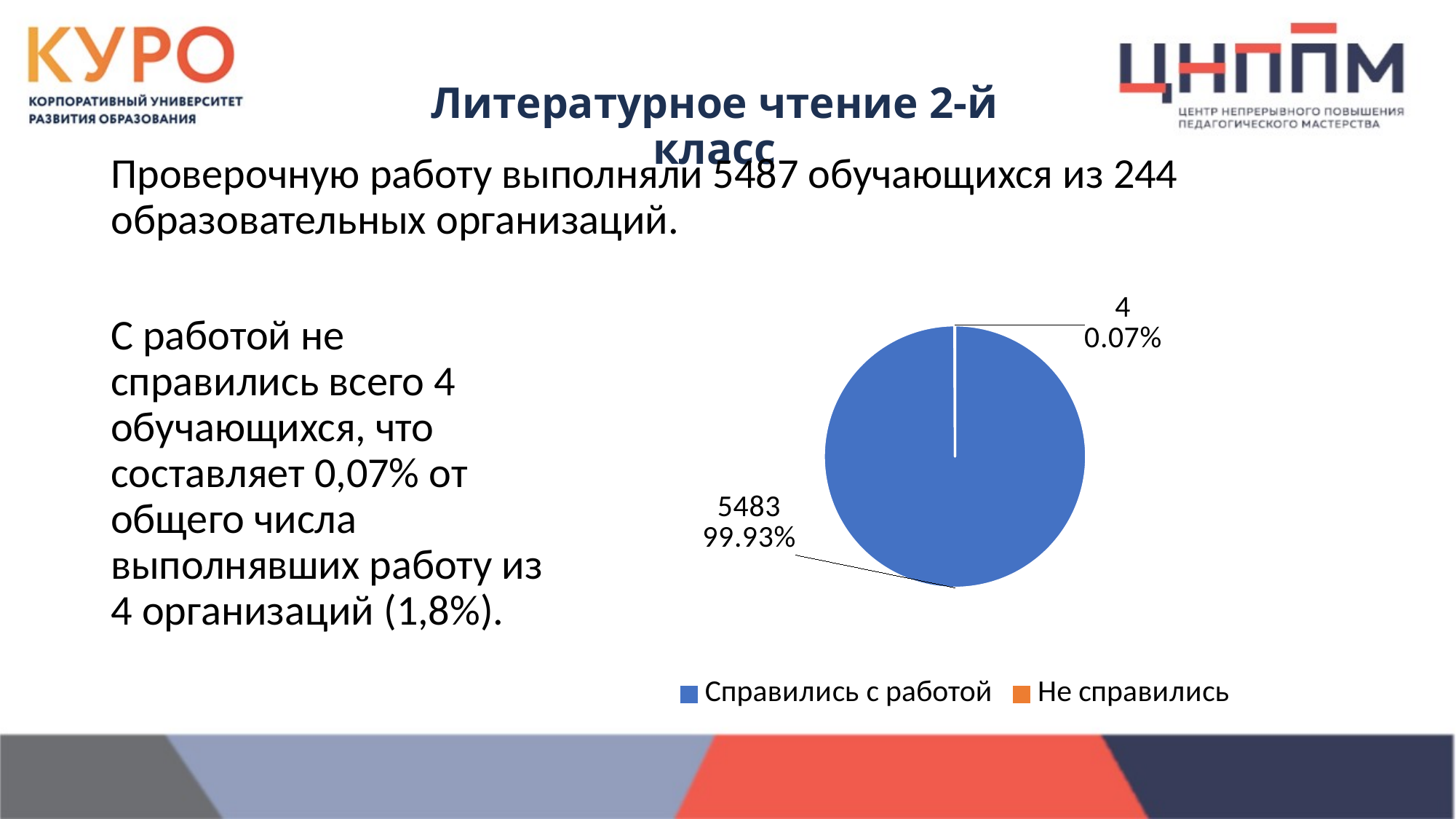
What kind of chart is shown on the slide? pie chart Which is larger in the pie chart: "Справились с работой" or "Не справились"? Справились с работой How many students are in the "Не справились" slice of the pie chart? 4 What is the difference between the number of students who completed the work and those who did not, according to the pie chart? 5479 How many students are in the "Справились с работой" slice of the pie chart? 5483 Which slice of the pie chart is the largest? Справились с работой Which slice of the pie chart is the smallest? Не справились How many entries does the legend of the pie chart list? 2 What share of the pie does the "Не справились" slice represent? 0.07% What colour is the "Не справились" entry in the pie chart legend? orange What share of the pie does the "Справились с работой" slice represent? 99.93% How many slices does the pie chart have? 2